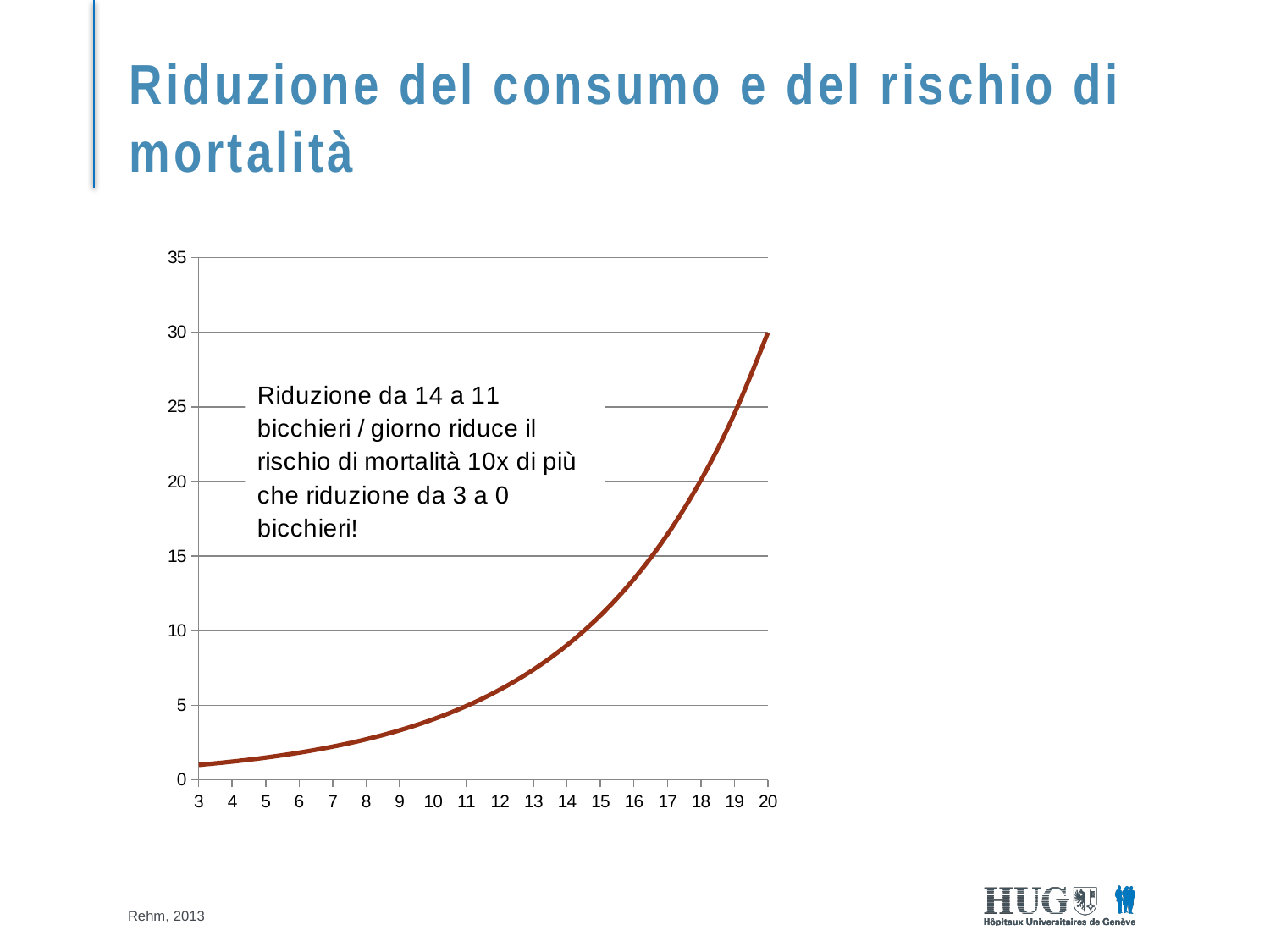
Is the value of the line at x = 14 greater or less than 10? less Is the value of the line at x = 15 greater or less than 10? greater At which x-axis value is the plotted line lowest? 3 What is the highest value shown on the y axis of the chart? 35 At which x-axis value is the plotted line highest? 20 Which has the larger value on the line, x = 20 or x = 3? 20 Is the value of the line at x = 10 greater or less than 5? less What kind of chart is shown on the slide? line chart Do the values rise or fall as the x axis goes from 3 to 20? rise How many x-axis tick labels are shown on the chart? 18